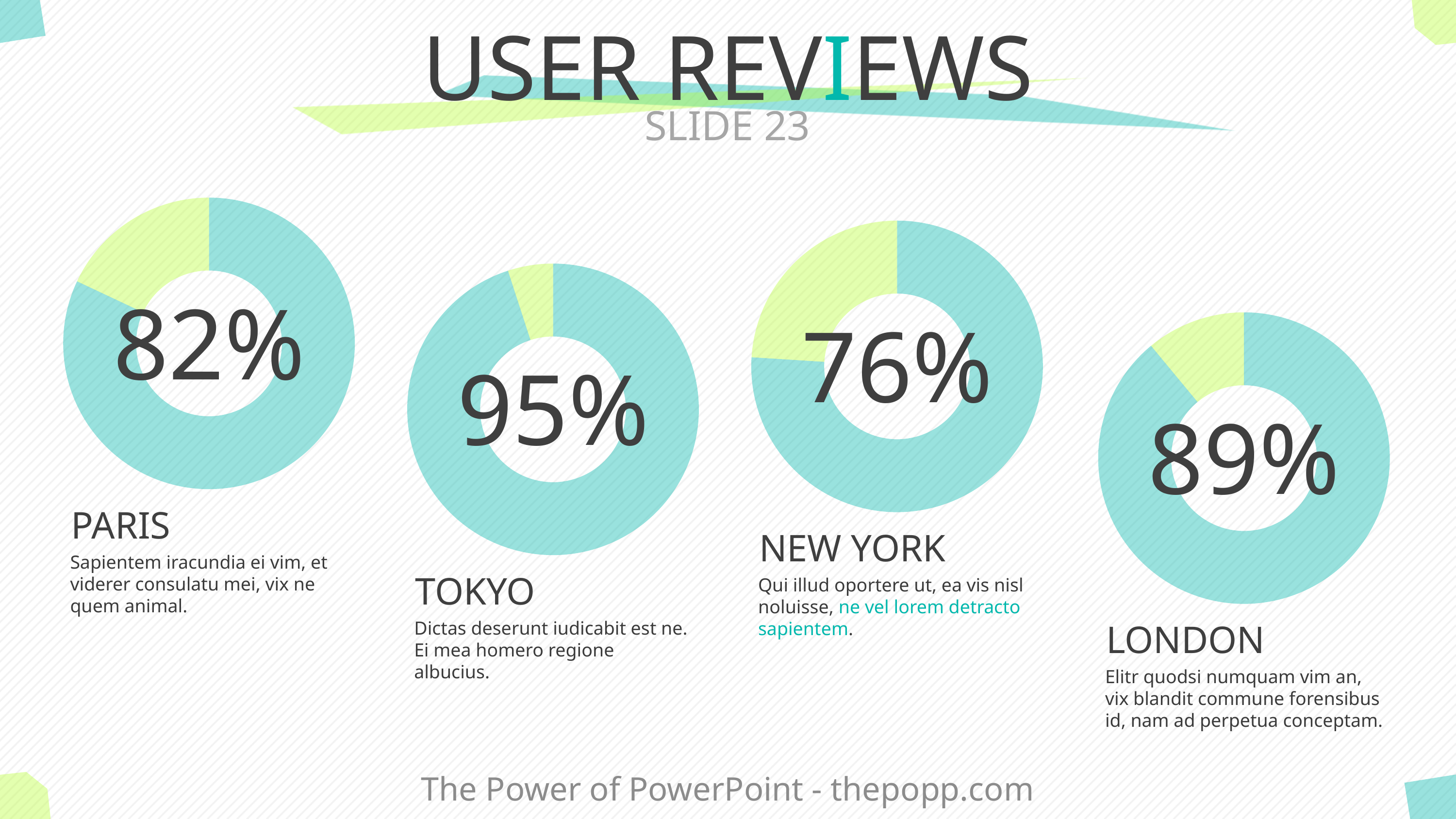
Which city has the lowest user review percentage? New York What kind of chart is used to show each city's percentage? Donut (pie) chart What percentage is shown in the New York donut chart? 76% What is the difference between the London and Paris percentages? 7% Which has the larger percentage, Paris or London? London How many donut charts are on the slide? 4 What percentage is shown in the Tokyo donut chart? 95% What percentage is shown in the Paris donut chart? 82% What is the title of the slide containing the charts? USER REVIEWS Which city has the highest user review percentage? Tokyo What is the difference between the Tokyo and New York percentages? 19% What percentage is shown in the London donut chart? 89%